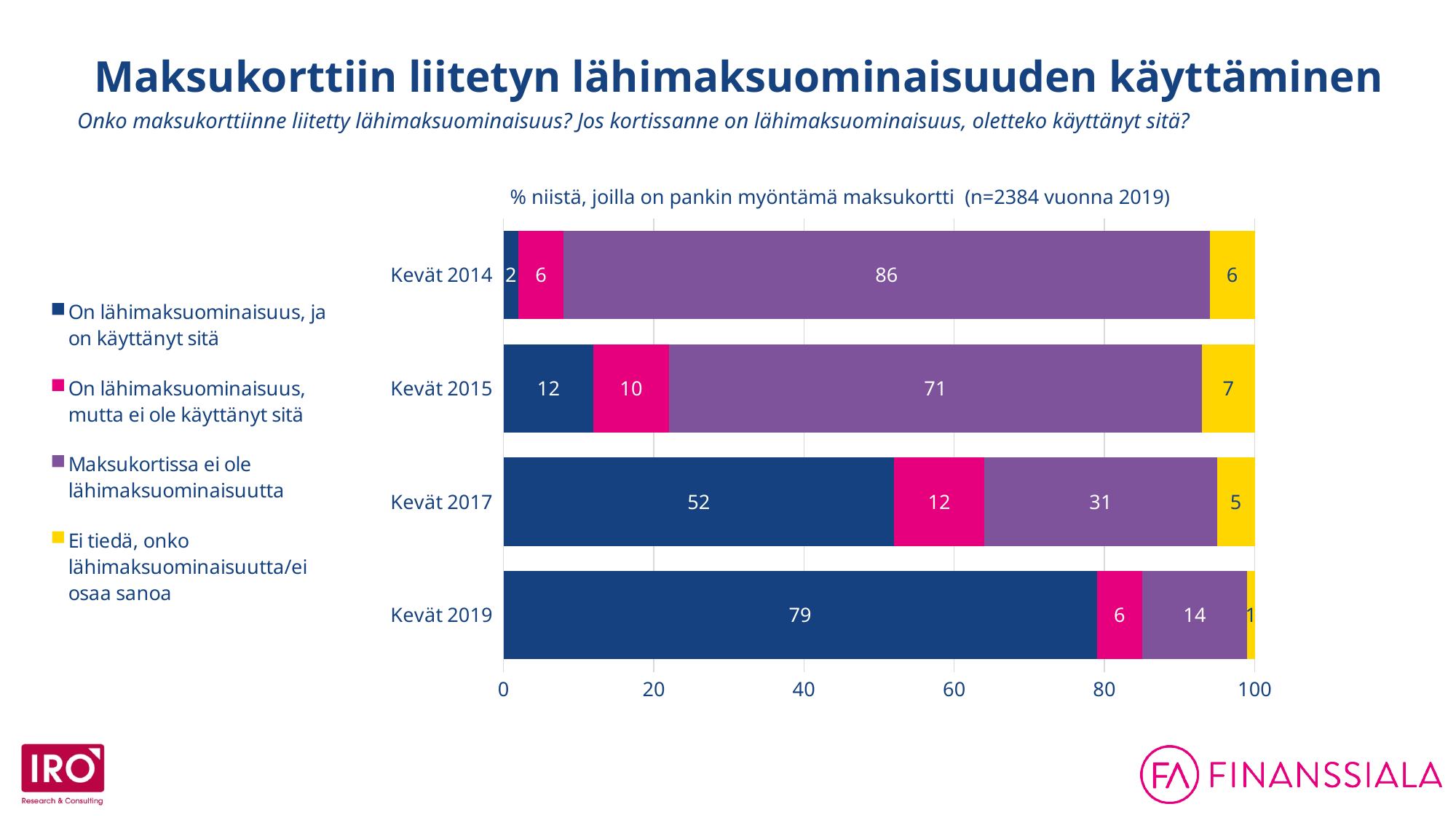
What is the difference between the 'On lähimaksuominaisuus, ja on käyttänyt sitä' values for Kevät 2019 and Kevät 2017? 27 What is the value for 'Maksukortissa ei ole lähimaksuominaisuutta' in Kevät 2014? 86 What is the value for 'On lähimaksuominaisuus, ja on käyttänyt sitä' in Kevät 2019? 79 In which survey round is the value for 'Maksukortissa ei ole lähimaksuominaisuutta' the lowest? Kevät 2019 In which survey round is the value for 'On lähimaksuominaisuus, ja on käyttänyt sitä' the highest? Kevät 2019 What kind of chart is shown on the slide? Stacked bar chart What is the total of the stacked bar for Kevät 2017? 100 What is the value for 'On lähimaksuominaisuus, mutta ei ole käyttänyt sitä' in Kevät 2017? 12 Which is larger: the 'Ei tiedä' value for Kevät 2015 or for Kevät 2019? Kevät 2015 How many series does the legend list? 4 Does the value for 'On lähimaksuominaisuus, ja on käyttänyt sitä' rise or fall from Kevät 2014 to Kevät 2019? Rise How many categories (survey rounds) are shown on the chart? 4